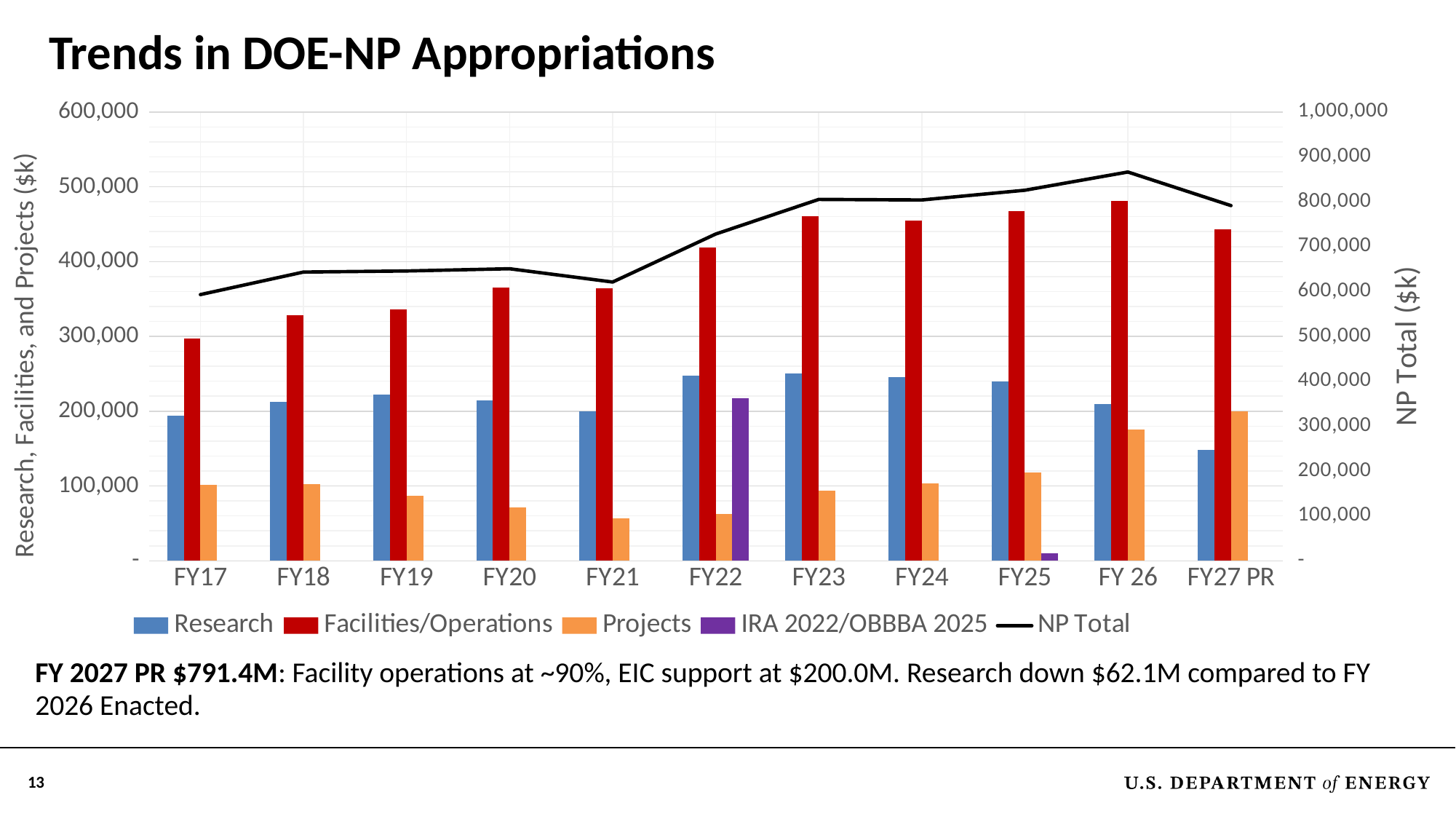
Is the Research value for FY27 PR greater or less than 200,000? less Which is larger, the Research value for FY17 or for FY22? FY22 How many fiscal years are shown on the x axis? 11 Which fiscal year has the highest Facilities/Operations value? FY 26 What kind of chart is shown on the slide? bar chart with a line Does the NP Total line rise or fall from FY 26 to FY27 PR? fall Which fiscal year has the highest Projects value? FY27 PR Which fiscal year has the lowest Research value? FY27 PR Is the Facilities/Operations value for FY22 greater or less than 400,000? greater Is the NP Total for FY22 greater or less than 700,000? greater How many series does the legend list? 5 Which fiscal year has the lowest NP Total? FY17